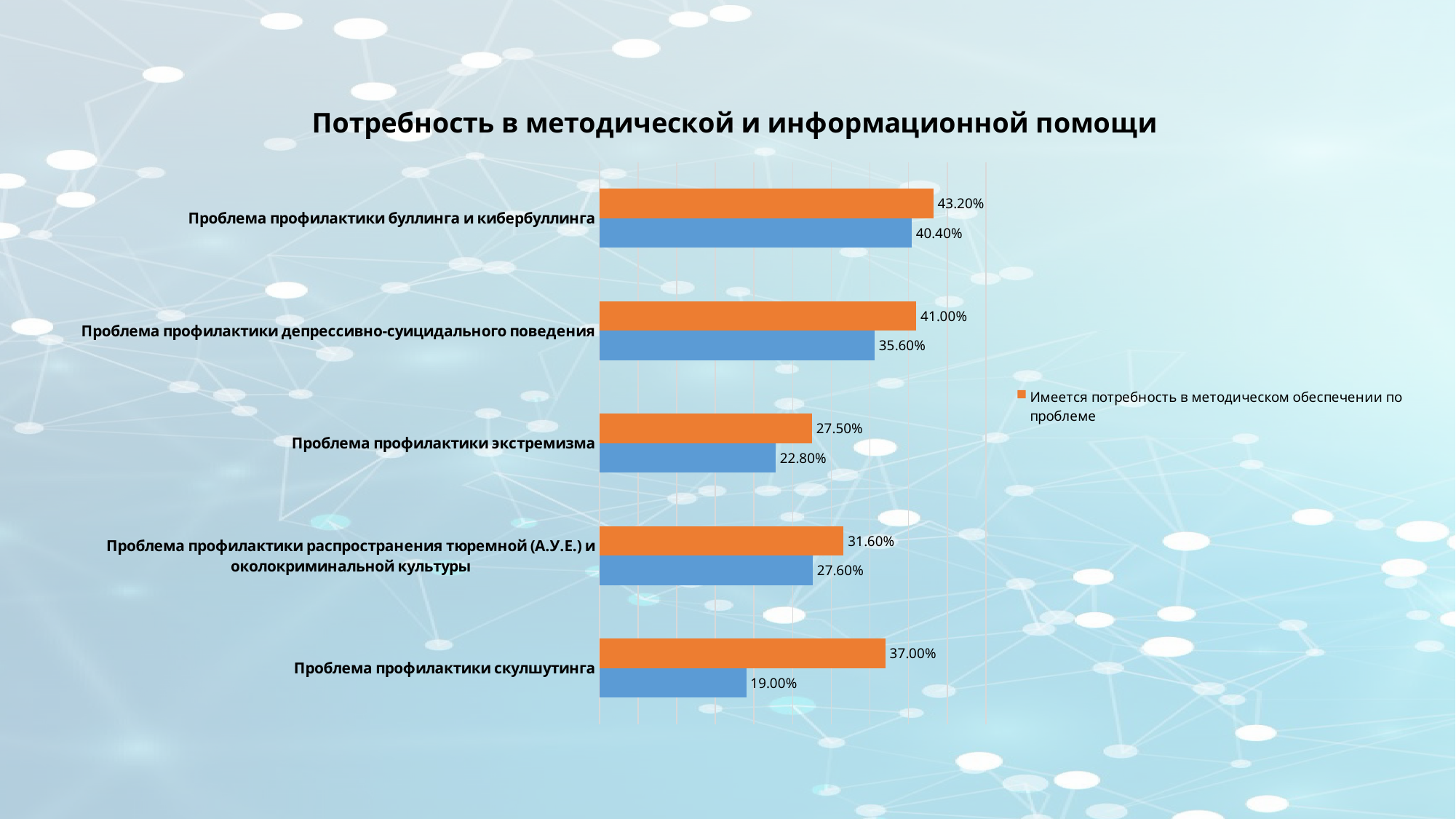
What is the title of the chart? Потребность в методической и информационной помощи How many categories (problems) are shown in the chart? 5 Which category has the highest orange bar value? Проблема профилактики буллинга и кибербуллинга What is the value of the blue bar for 'Проблема профилактики скулшутинга'? 19.00% How many series does the legend list? 1 Which is larger: the blue bar for 'Проблема профилактики депрессивно-суицидального поведения' or the blue bar for 'Проблема профилактики распространения тюремной (А.У.Е.) и околокриминальной культуры'? Проблема профилактики депрессивно-суицидального поведения What is the value of the orange bar for 'Проблема профилактики буллинга и кибербуллинга'? 43.20% What is the difference between the orange bar values for 'Проблема профилактики буллинга и кибербуллинга' and 'Проблема профилактики депрессивно-суицидального поведения'? 2.20% What is the value of the orange bar for 'Проблема профилактики экстремизма'? 27.50% What type of chart is shown on the slide? Bar chart What is the difference between the orange and blue bar values for 'Проблема профилактики скулшутинга'? 18.00% Which category has the lowest blue bar value? Проблема профилактики скулшутинга